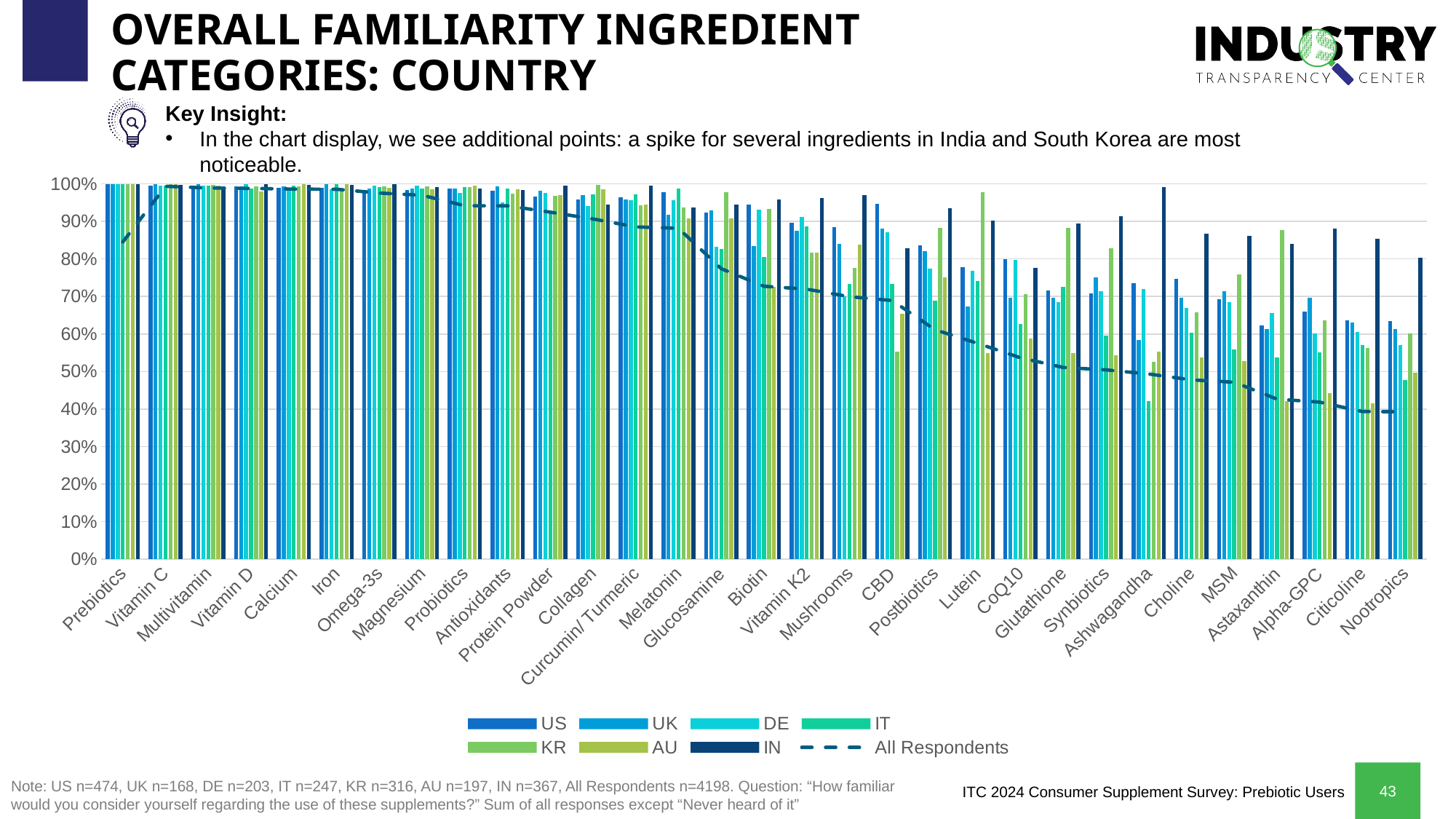
Is the KR value for Astaxanthin greater or less than 80%? greater Is the IN value for Choline greater or less than 90%? less Is the KR value for Lutein greater or less than 90%? greater What kind of chart is shown on the slide? combination bar and line chart How many entries does the chart's legend list? 8 How many ingredient categories are shown on the x axis of the chart? 31 Which category is listed first on the x axis of the chart? Prebiotics Does the All Respondents dashed line rise or fall from left to right across the chart? fall Which legend entry is drawn as a dashed line rather than bars? All Respondents